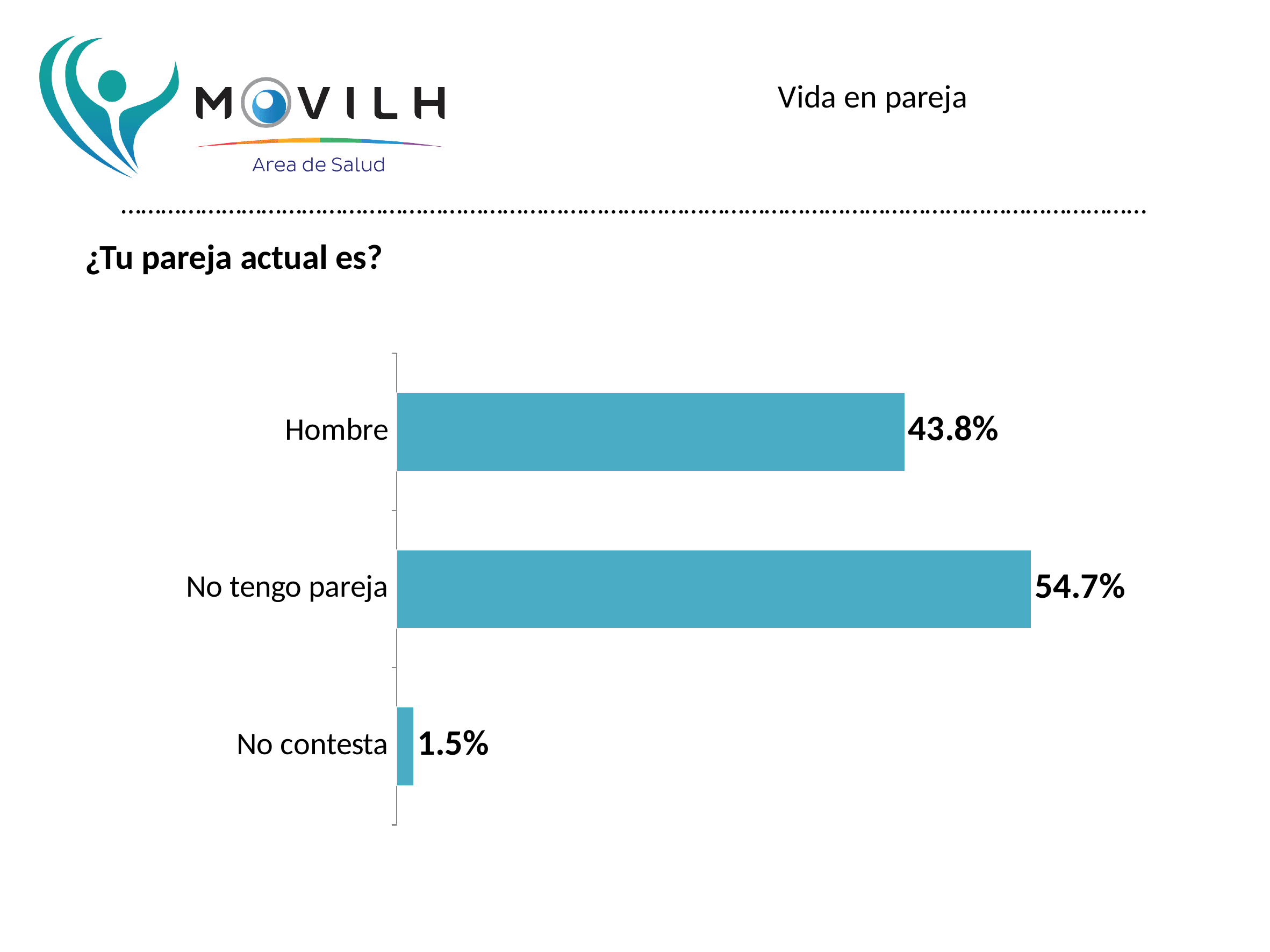
What is the value for No tengo pareja? 54.7% What is the difference between the values for No tengo pareja and Hombre? 10.9% What is the value for Hombre? 43.8% What is the value for No contesta? 1.5% What kind of chart is shown on the slide? Bar chart What is the difference between the values for Hombre and No contesta? 42.3% How many categories are shown in the chart? 3 Which is larger, the value for Hombre or the value for No contesta? Hombre What question does the chart title ask? ¿Tu pareja actual es? Which category has the lowest value? No contesta Which category has the highest value? No tengo pareja Which is larger, the value for Hombre or the value for No tengo pareja? No tengo pareja